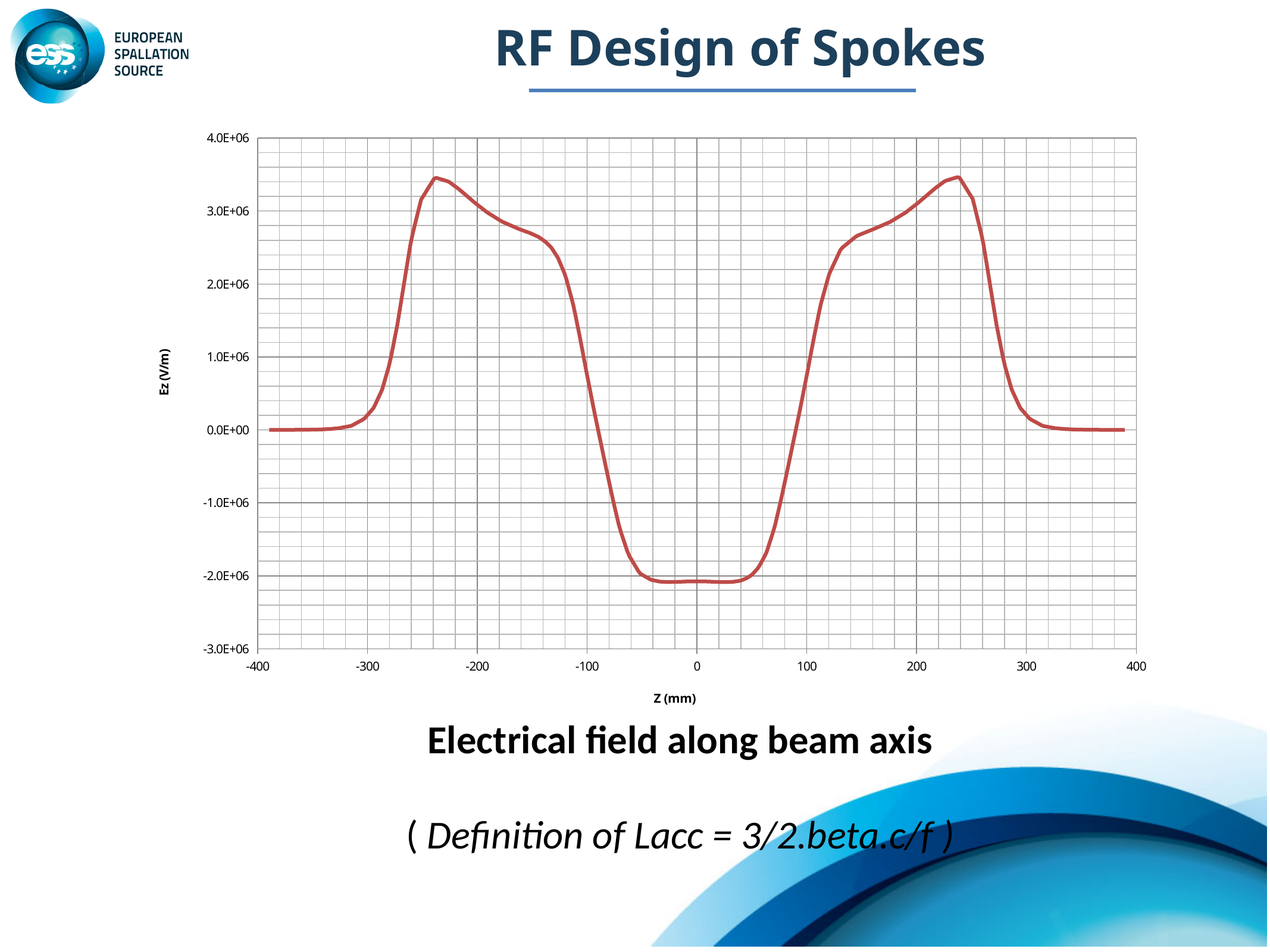
Is the value of Ez at Z = -300 mm greater or less than 1.0E+06? less What kind of chart is shown on the slide? line chart What is the label of the y axis of the chart? Ez (V/m) Is the value of Ez at Z = 200 mm greater or less than 2.0E+06? greater Between Z = 0 mm and Z = 240 mm, does the value of Ez rise or fall? rise Is the value of Ez at Z = -200 mm greater or less than 2.0E+06? greater Between Z = -100 mm and Z = 0 mm, does the value of Ez rise or fall? fall What is the label of the x axis of the chart? Z (mm) How many lines (series) are plotted on the chart? 1 Which is larger: the value of Ez at Z = -200 mm or at Z = 0 mm? Z = -200 mm